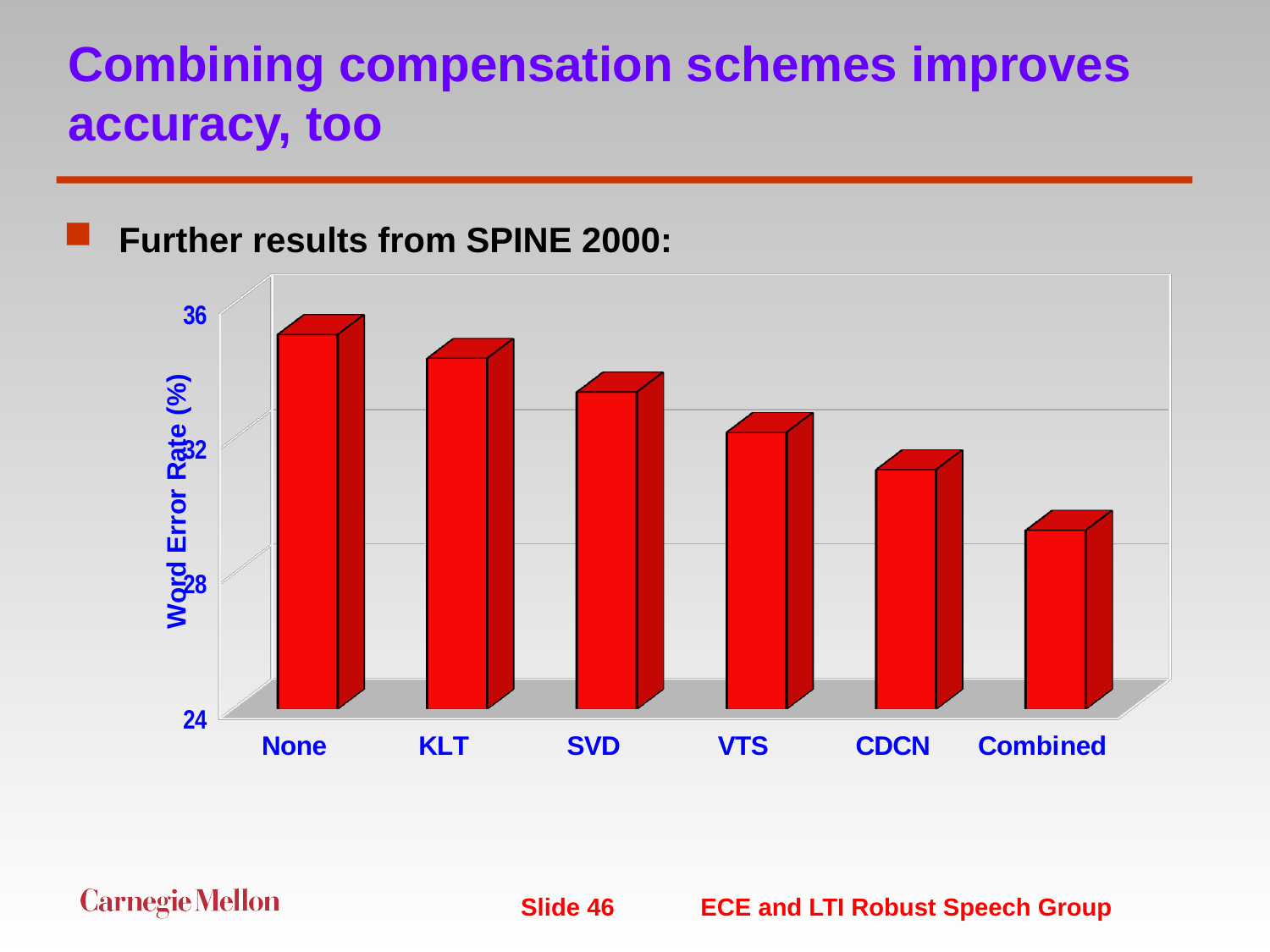
What kind of chart is shown on the slide? bar chart Which category has the highest word error rate? None What is the label of the y axis of the chart? Word Error Rate (%) How many categories are shown on the x axis of the chart? 6 Is the word error rate for SVD greater or less than 32? greater Which has a higher word error rate, KLT or CDCN? KLT Is the word error rate for Combined greater or less than 28? greater Which category has the lowest word error rate? Combined Is the word error rate for None greater or less than 36? less Do the word error rates rise or fall moving from None to Combined along the x axis? fall